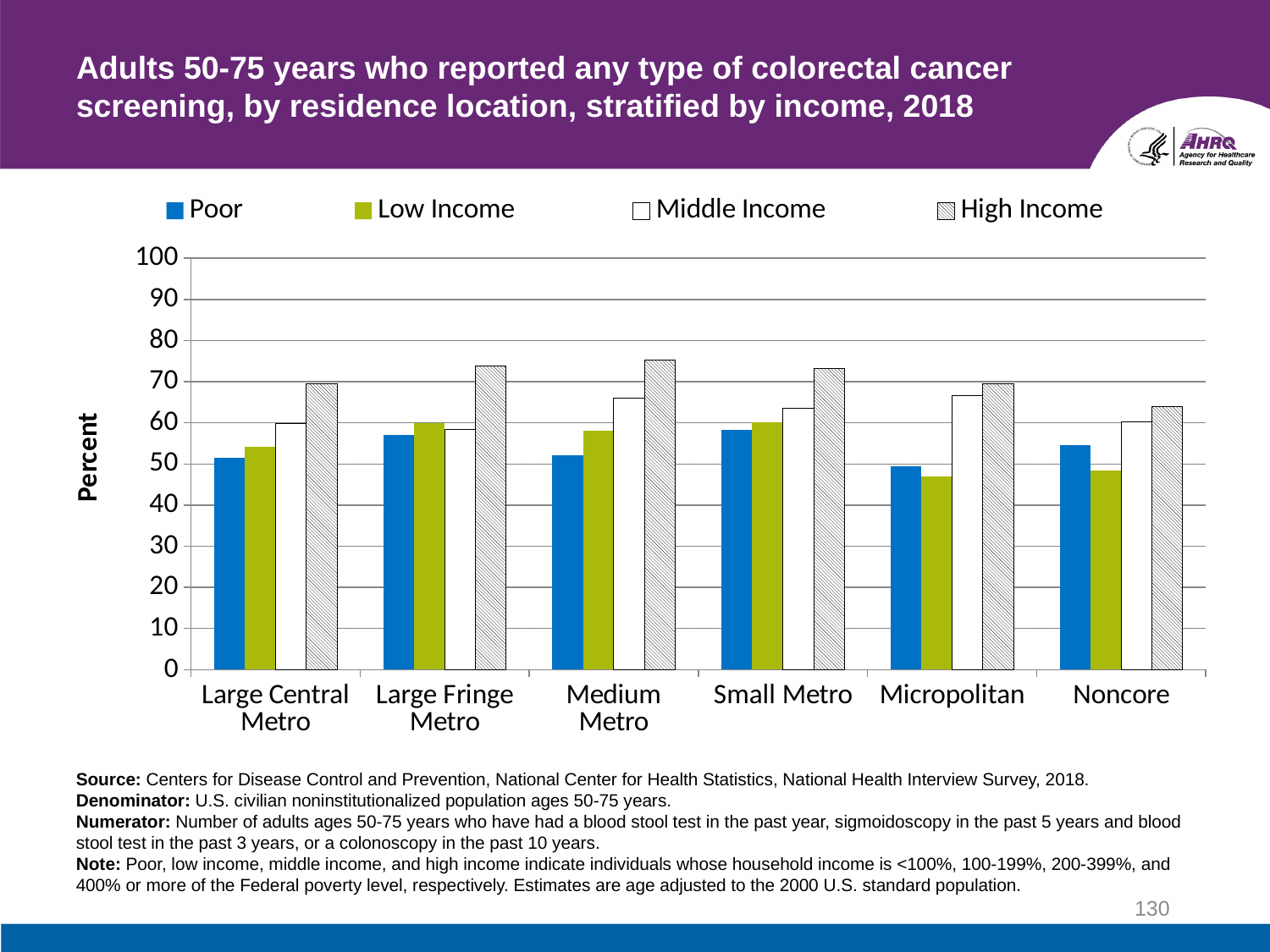
Which income group has the highest value for Medium Metro? High Income Which series is shown in blue in the legend? Poor Which is larger: the High Income value for Medium Metro or the High Income value for Noncore? Medium Metro Is the Low Income value for Micropolitan greater or less than 50? less Is the High Income value for Medium Metro greater or less than 70? greater Is the Poor value for Large Central Metro greater or less than 60? less How many residence location categories are shown on the x axis? 6 Which income group has the lowest value for Micropolitan? Low Income For Noncore, which is larger: the Poor value or the Low Income value? Poor What kind of chart is shown on the slide? Bar chart How many series does the legend list? 4 What is the label on the y axis? Percent